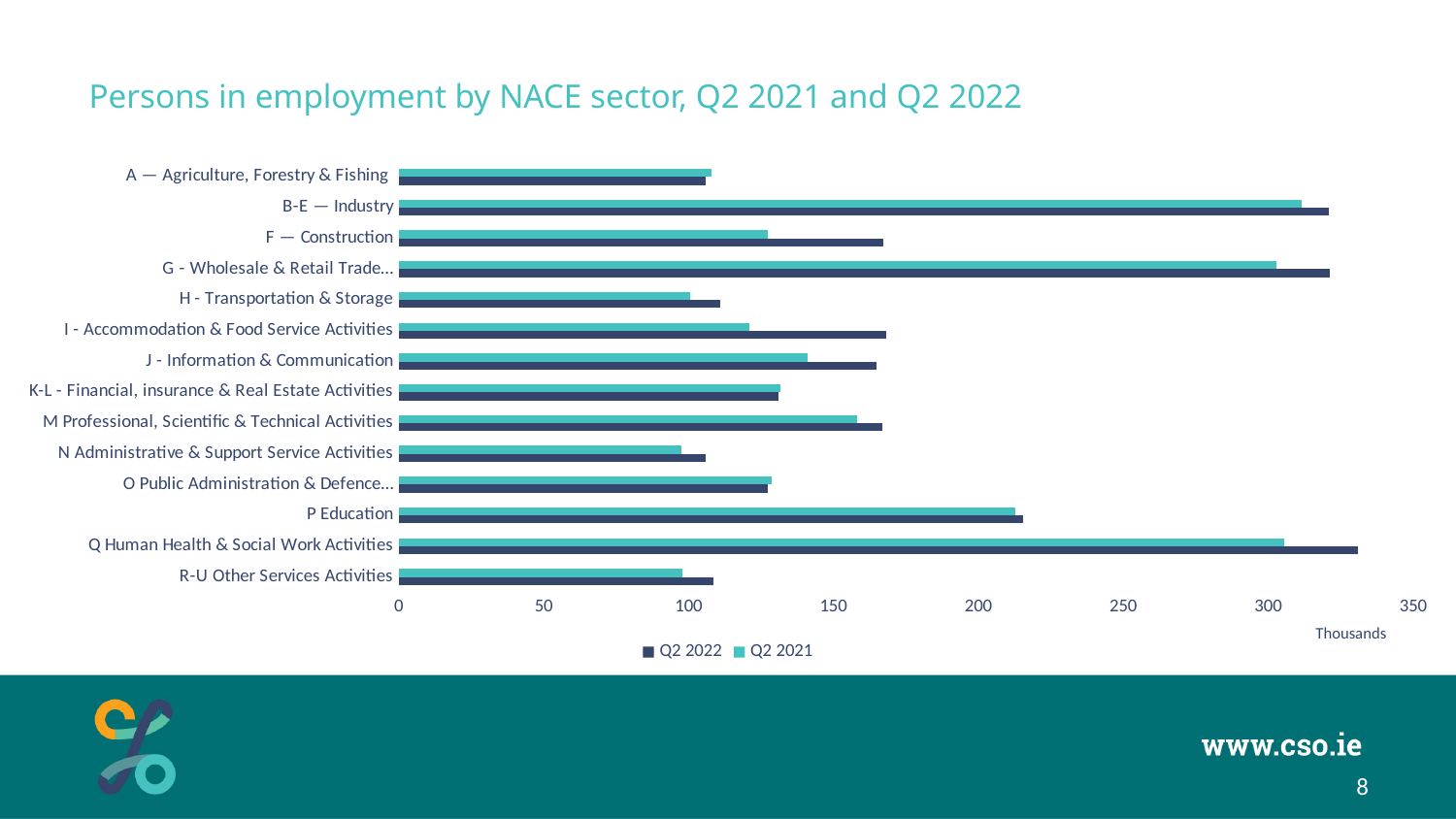
Is the Q2 2022 value for Q Human Health & Social Work Activities greater or less than 300? greater What unit is shown on the horizontal axis? Thousands How many NACE sectors (categories) are plotted on the chart? 14 Which is larger in Q2 2022: B-E — Industry or F — Construction? B-E — Industry Is the Q2 2022 value for P Education greater or less than 200? greater Which sector has the highest Q2 2022 value? Q Human Health & Social Work Activities What kind of chart is shown on the slide? bar chart How many series does the legend list? 2 Is the Q2 2022 value for F — Construction greater or less than 150? greater For I - Accommodation & Food Service Activities, which is larger: the Q2 2022 value or the Q2 2021 value? Q2 2022